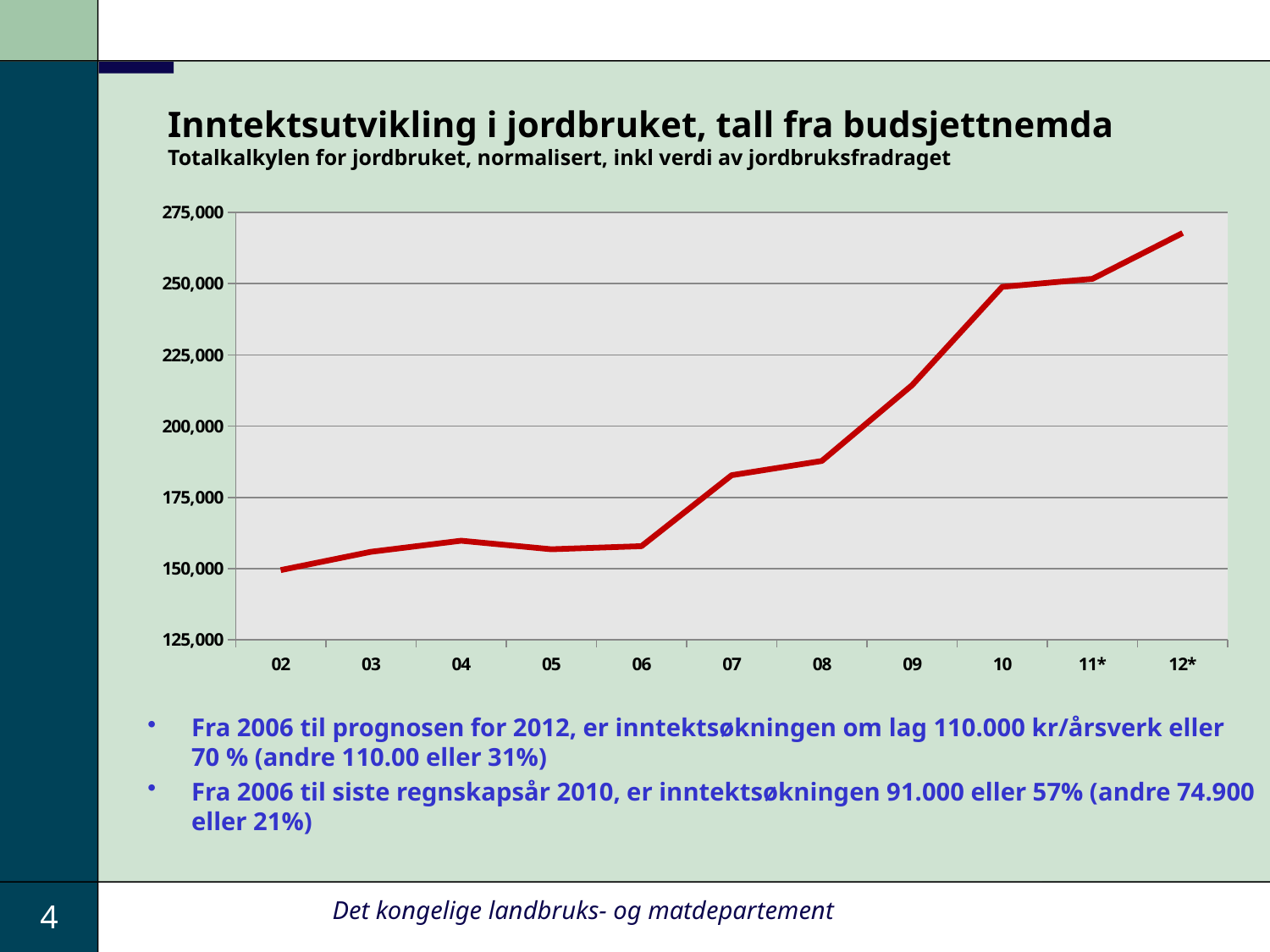
Is the value for 09 greater or less than 200,000? greater Is the value for 07 greater or less than 175,000? greater What is the title of the chart? Inntektsutvikling i jordbruket, tall fra budsjettnemda Is the value for 12* greater or less than 250,000? greater Do the values generally rise or fall from 02 to 12*? rise Which is larger, the value for 09 or the value for 08? 09 Which year has the lowest value on the chart? 02 How many years (points) are plotted along the x axis? 11 What kind of chart is shown on the slide? line chart Which year has the highest value on the chart? 12*